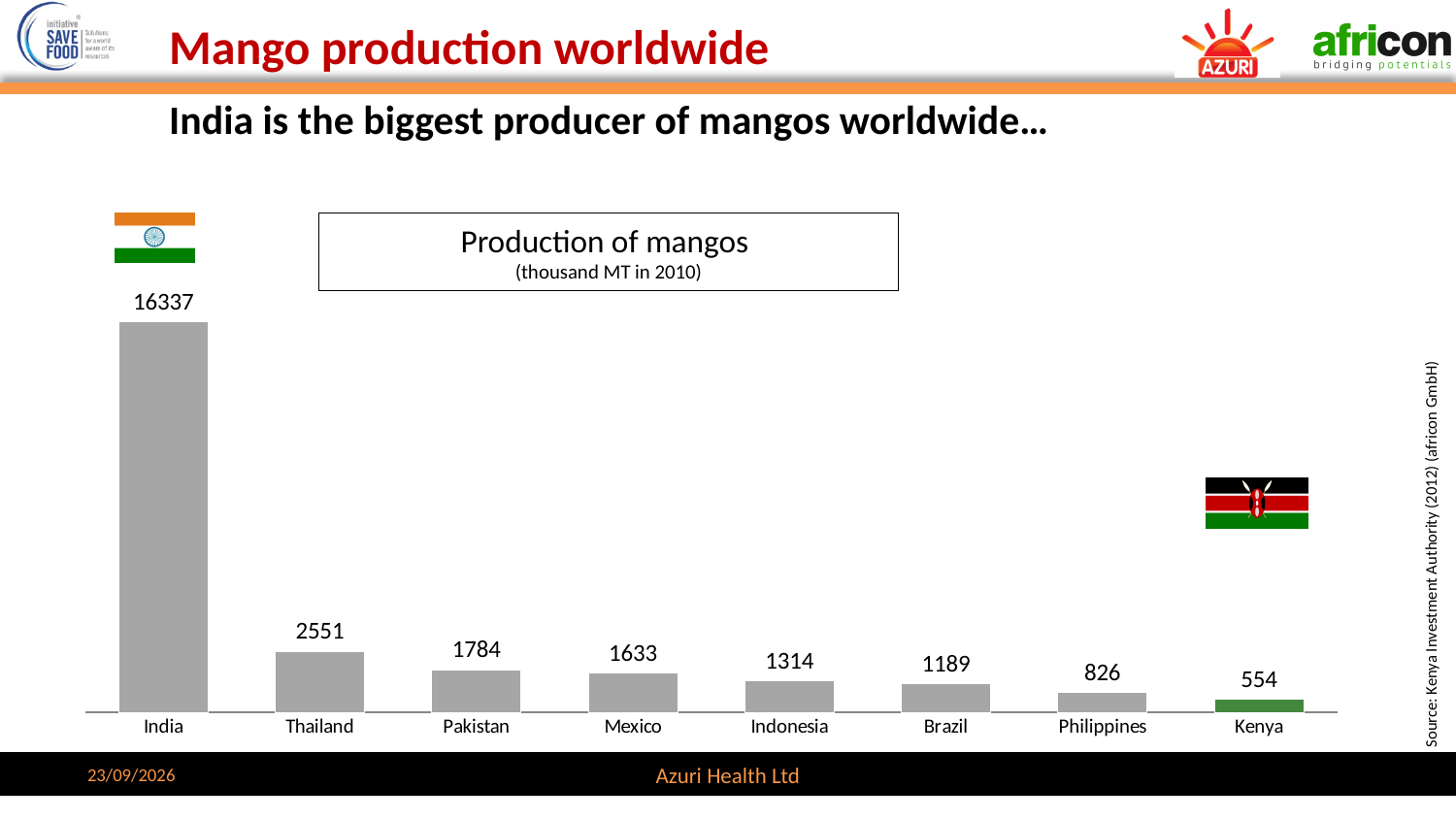
What is the mango production value shown for Kenya? 554 What type of chart is used to show mango production? Bar chart Which has a higher mango production value, Mexico or Indonesia? Mexico What is the difference between the mango production values of Philippines and Kenya? 272 How many countries are shown in the chart? 8 What unit is given in the chart's subtitle? thousand MT in 2010 What is the difference between the mango production values of Thailand and Pakistan? 767 What is the mango production value shown for India? 16337 Which country has the highest mango production in the chart? India What is the mango production value shown for Brazil? 1189 What is the mango production value shown for Thailand? 2551 Which country has the lowest mango production in the chart? Kenya